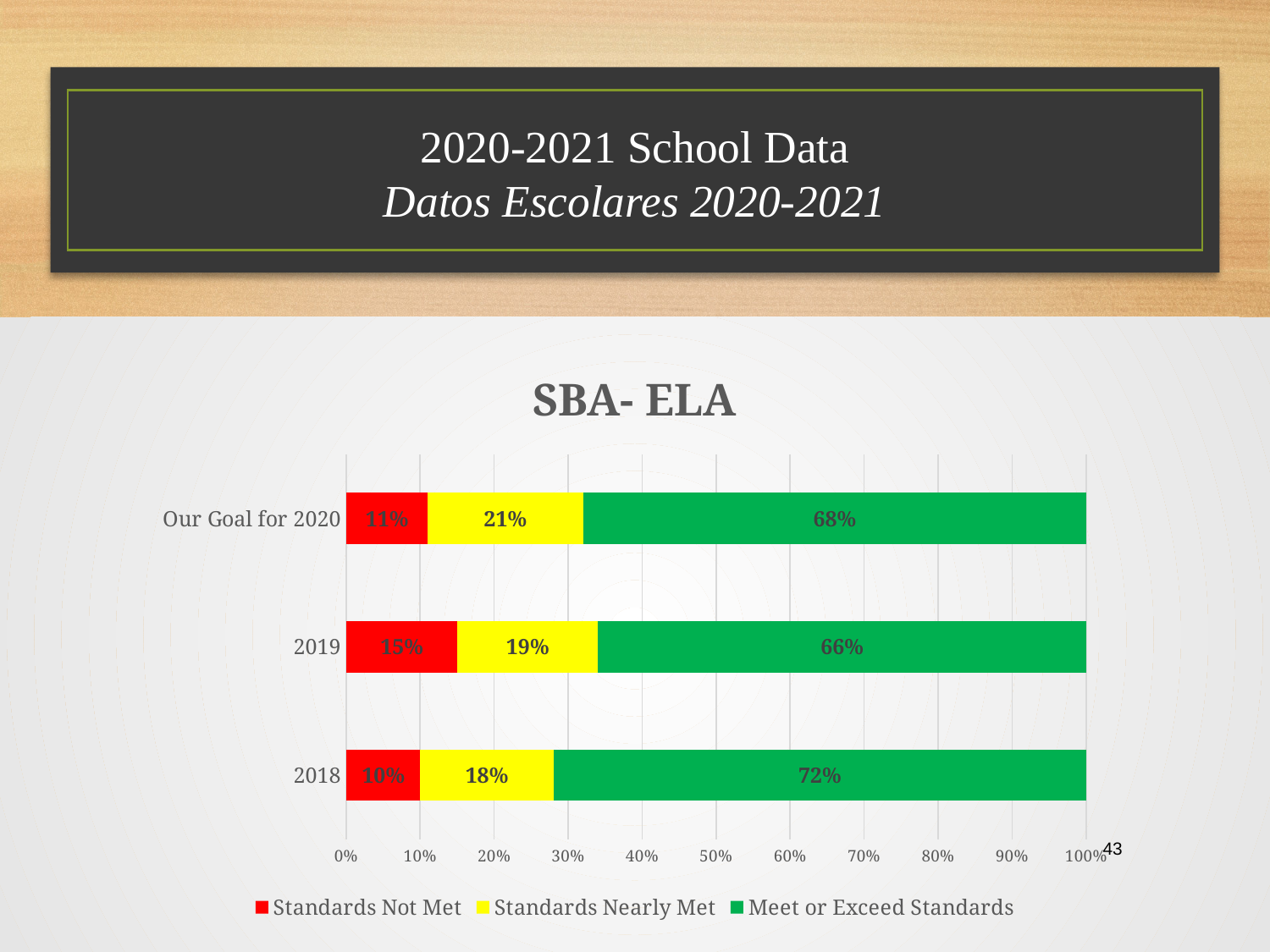
How many categories are shown on the chart? 3 What is the difference between the Meet or Exceed Standards values for 2018 and 2019? 6% What kind of chart is shown on the slide? Stacked bar chart What is the total of the stacked bar for 2019? 100% Which category has the lowest Standards Not Met value? 2018 What is the Standards Nearly Met value for 2019? 19% How many series does the legend list? 3 What is the Meet or Exceed Standards value for 2018? 72% What is the Standards Not Met value for Our Goal for 2020? 11% What is the title of the chart? SBA- ELA Which is larger, the Standards Nearly Met value for Our Goal for 2020 or for 2018? Our Goal for 2020 Which category has the highest Meet or Exceed Standards value? 2018